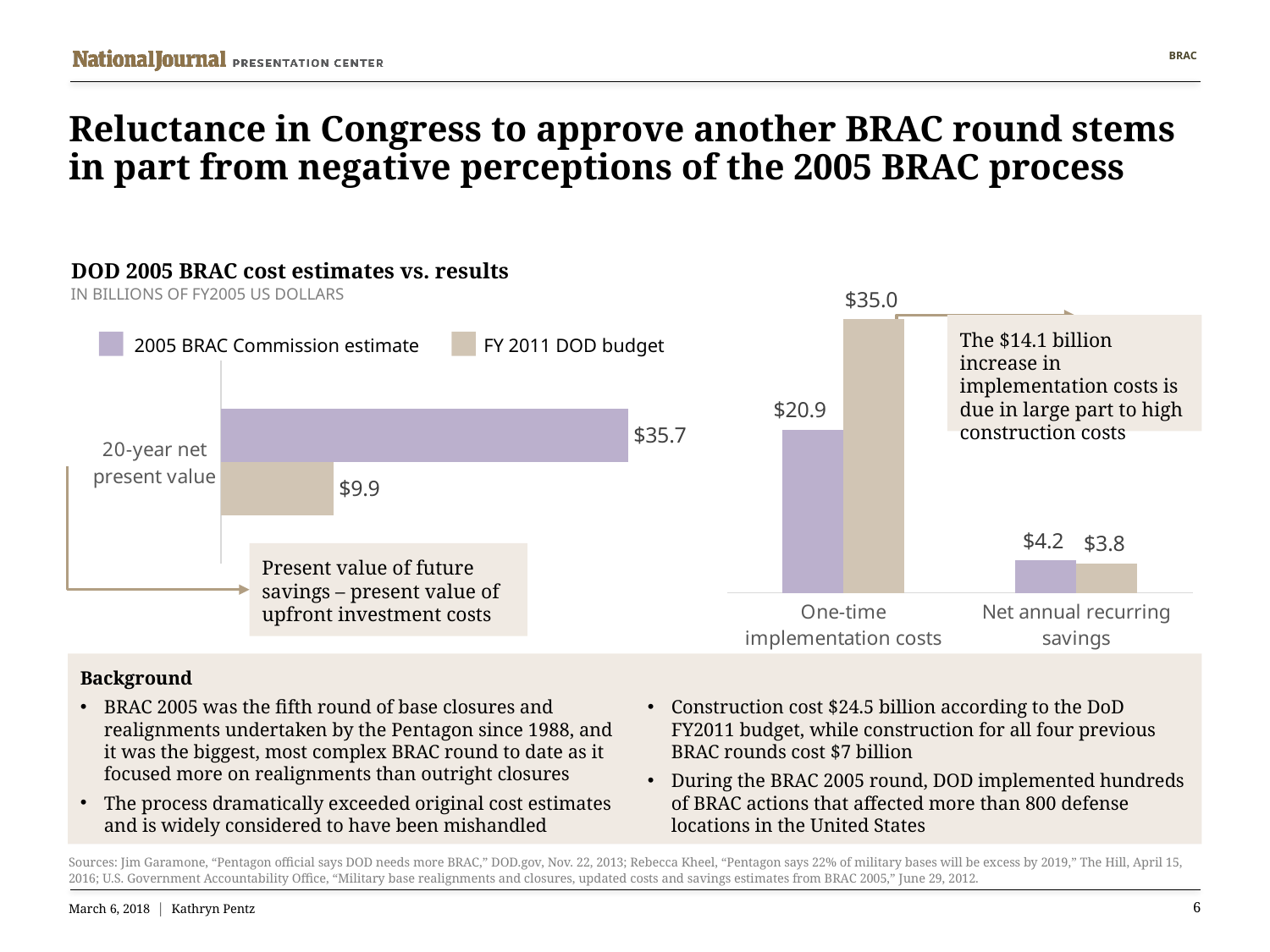
In the left chart (20-year net present value), what is the difference between the 2005 BRAC Commission estimate and the FY 2011 DOD budget? $25.8 In the right chart, which series has the higher value for one-time implementation costs? FY 2011 DOD budget In the right chart, how many categories are shown on the x axis? 2 In the right chart, what is the difference between the FY 2011 DOD budget and the 2005 BRAC Commission estimate for one-time implementation costs? $14.1 In the right chart, what is the FY 2011 DOD budget value for net annual recurring savings? $3.8 How many series does the legend list? 2 What type of chart is the right chart? Bar chart In the right chart, what is the 2005 BRAC Commission estimate for net annual recurring savings? $4.2 In the left chart (20-year net present value), what is the value for the 2005 BRAC Commission estimate? $35.7 In the left chart (20-year net present value), what is the value for the FY 2011 DOD budget? $9.9 In the right chart, what is the FY 2011 DOD budget value for one-time implementation costs? $35.0 In the right chart, what is the 2005 BRAC Commission estimate for one-time implementation costs? $20.9